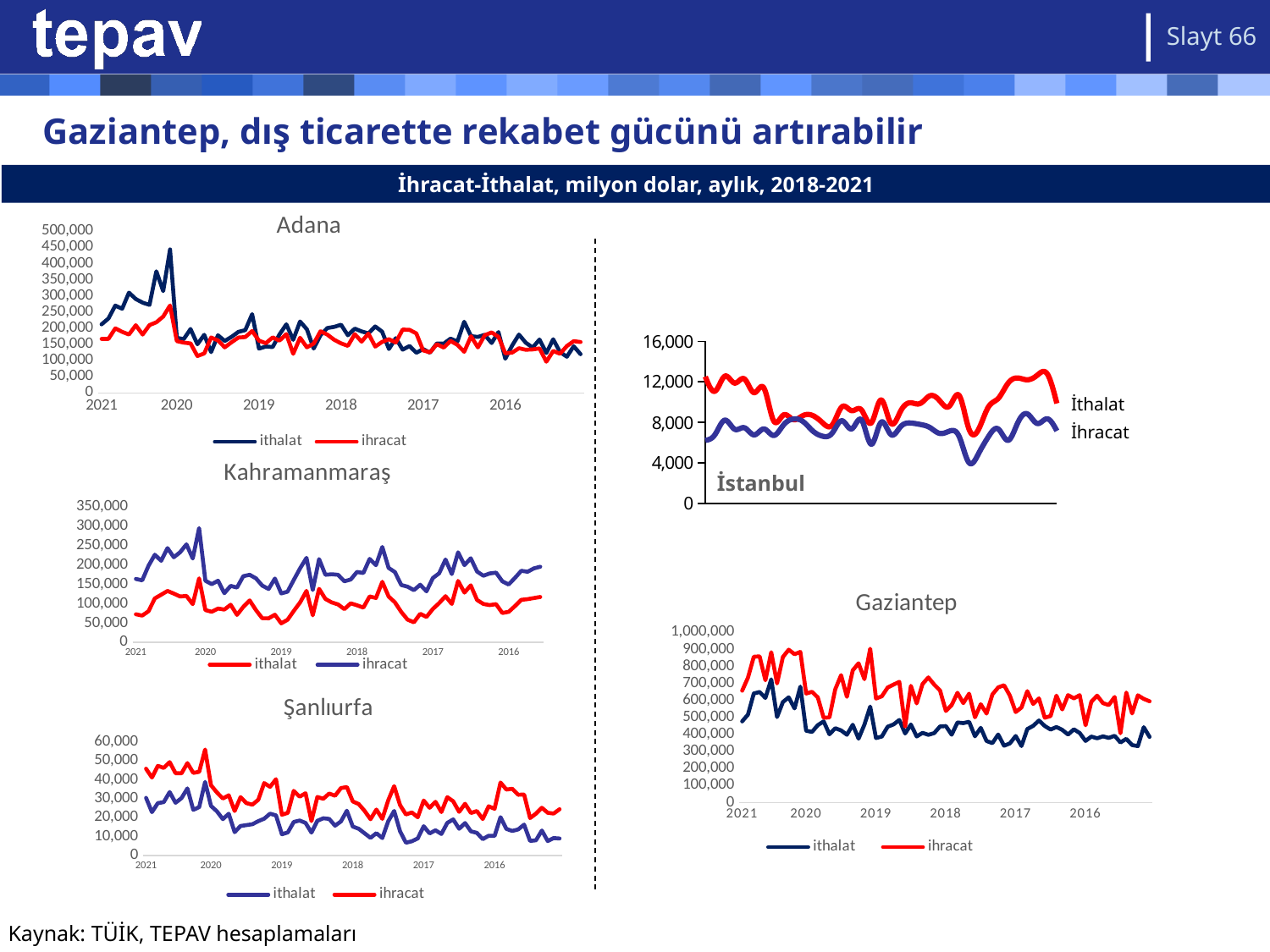
How many series does the legend of the Adana chart list? 2 How many charts are shown on the slide? 5 In the Kahramanmaraş chart, is the highest value of ihracat greater or less than 250,000? greater In the Gaziantep chart, is the highest value of ihracat greater or less than 800,000? greater In the Gaziantep chart, which series is generally higher, ithalat or ihracat? ihracat What is the title of the banner above the charts? İhracat-İthalat, milyon dolar, aylık, 2018-2021 In the Şanlıurfa chart, is the highest value of ithalat greater or less than 50,000? less In the İstanbul chart, which series is generally higher, İthalat or İhracat? İthalat In the Gaziantep chart, does the ithalat line generally rise or fall moving from left (2021) to right (2016)? fall What kind of chart is the Gaziantep chart? line chart